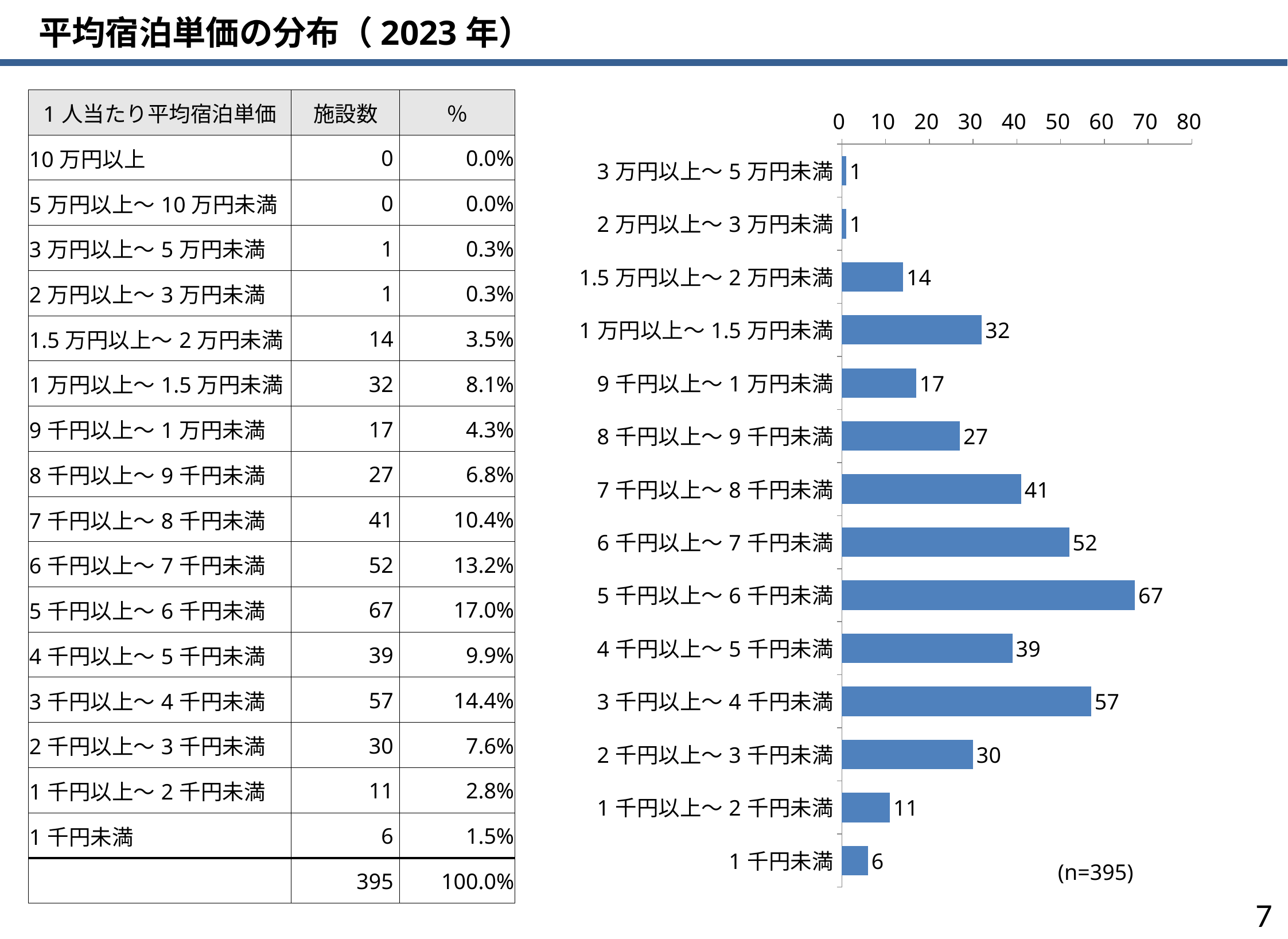
What is the value for 1万円以上～1.5万円未満 in the bar chart? 32 What kind of chart is shown on the slide? bar chart What is the maximum value shown on the horizontal axis of the bar chart? 80 How many categories are shown in the bar chart? 14 What is the value for 1千円未満 in the bar chart? 6 What is the sample size (n) noted on the bar chart? n=395 What is the difference between the values for 8千円以上～9千円未満 and 9千円以上～1万円未満? 10 Is the value for 6千円以上～7千円未満 greater or less than 50? greater What is the difference between the values for 5千円以上～6千円未満 and 3千円以上～4千円未満? 10 Which category has the highest value in the bar chart? 5千円以上～6千円未満 Which is larger in the bar chart: 7千円以上～8千円未満 or 4千円以上～5千円未満? 7千円以上～8千円未満 What is the value for 5千円以上～6千円未満 in the bar chart? 67